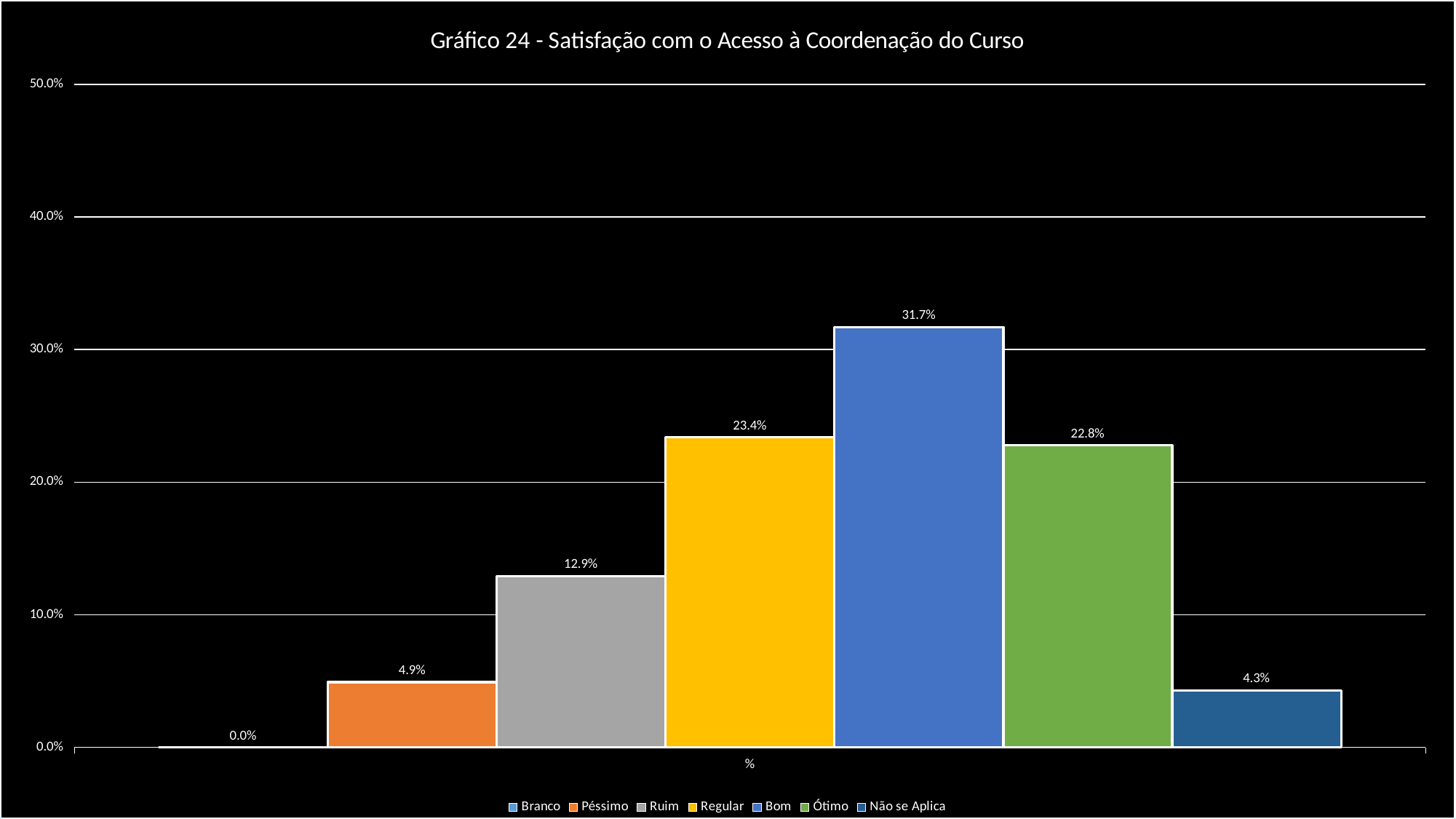
Which series has the lowest value? Branco What is the value for Não se Aplica? 4.3% What is the value for Regular? 23.4% What is the value for Ótimo? 22.8% Which series has the highest value? Bom Which is larger, the value for Ruim or the value for Péssimo? Ruim What is the value for Bom? 31.7% What is the title of the chart? Gráfico 24 - Satisfação com o Acesso à Coordenação do Curso How many series does the legend list? 7 What is the difference between the values for Bom and Regular? 8.3% What is the value for Péssimo? 4.9% What kind of chart is shown? Bar chart